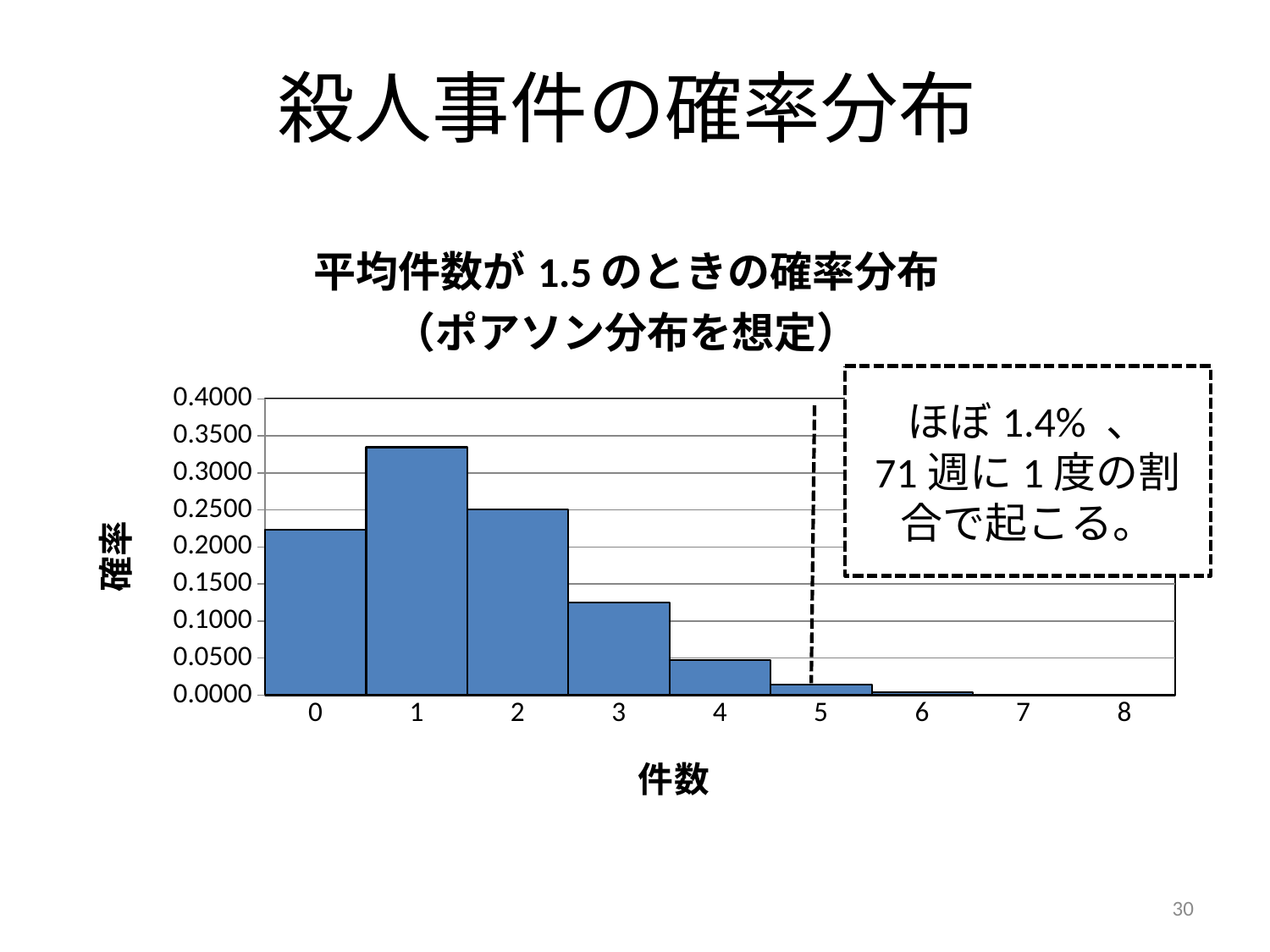
What is the label of the x axis? 件数 What kind of chart is shown on the slide? bar chart How many categories (件数 values) are shown on the x axis? 9 Is the value for 件数 3 greater or less than 0.1000? greater Which is larger, the value for 件数 0 or the value for 件数 2? 件数 2 What is the label of the y axis? 確率 Is the value for 件数 0 greater or less than 0.2000? greater Is the value for 件数 2 greater or less than 0.3000? less Which 件数 value has the highest 確率? 1 Do the values rise or fall along the x axis from 件数 1 to 件数 8? fall